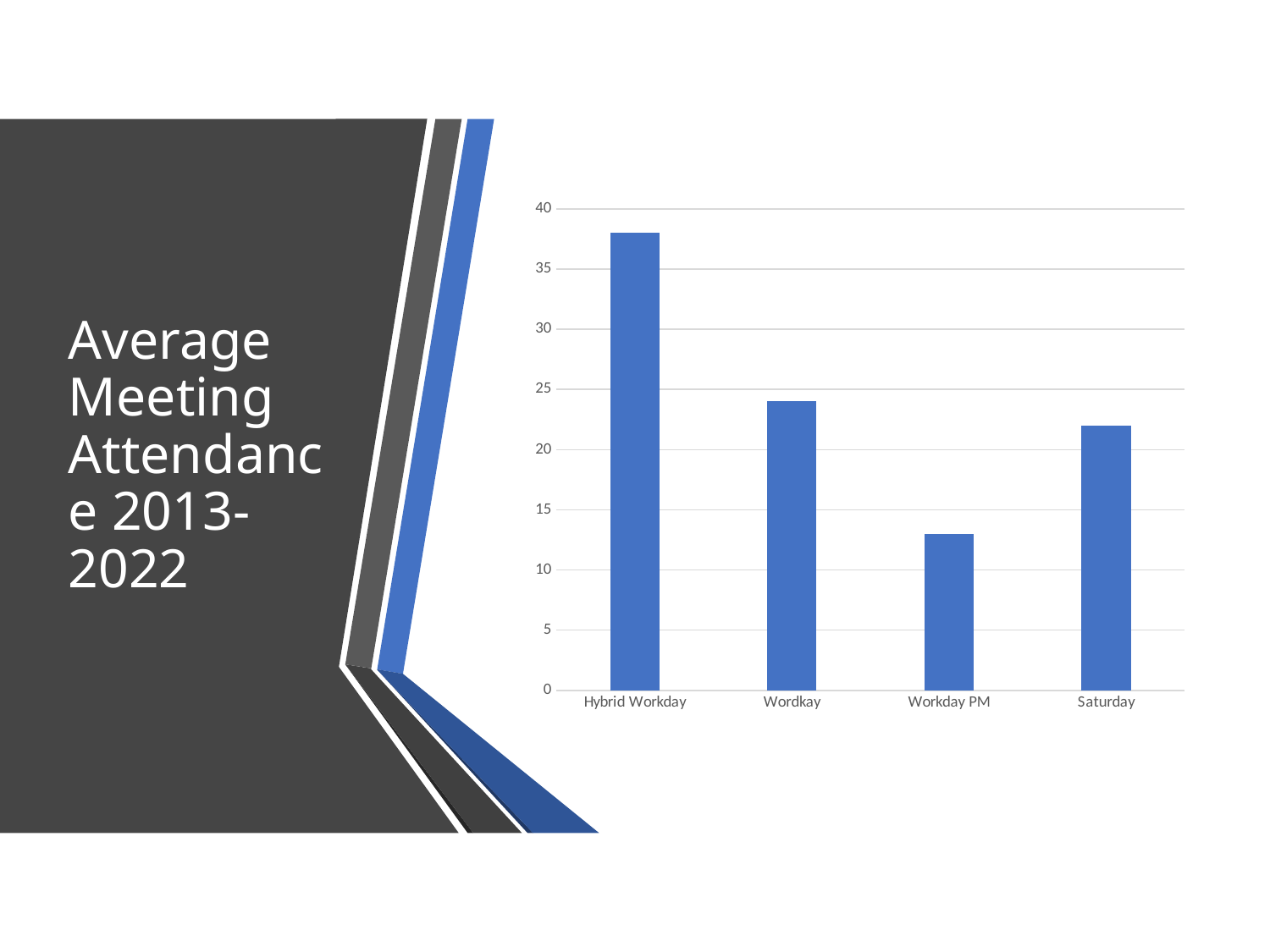
What kind of chart is shown on the slide? bar chart Is the value for Saturday greater or less than 25? less Is the value for Workday PM greater or less than 15? less Is the value for Wordkay greater or less than 20? greater Which is larger, the value for Hybrid Workday or the value for Wordkay? Hybrid Workday Which category has the lowest value in the chart? Workday PM How many categories are shown on the x axis of the chart? 4 What is the title shown on the slide next to the chart? Average Meeting Attendance 2013-2022 Which category has the highest value in the chart? Hybrid Workday Which is larger, the value for Workday PM or the value for Saturday? Saturday